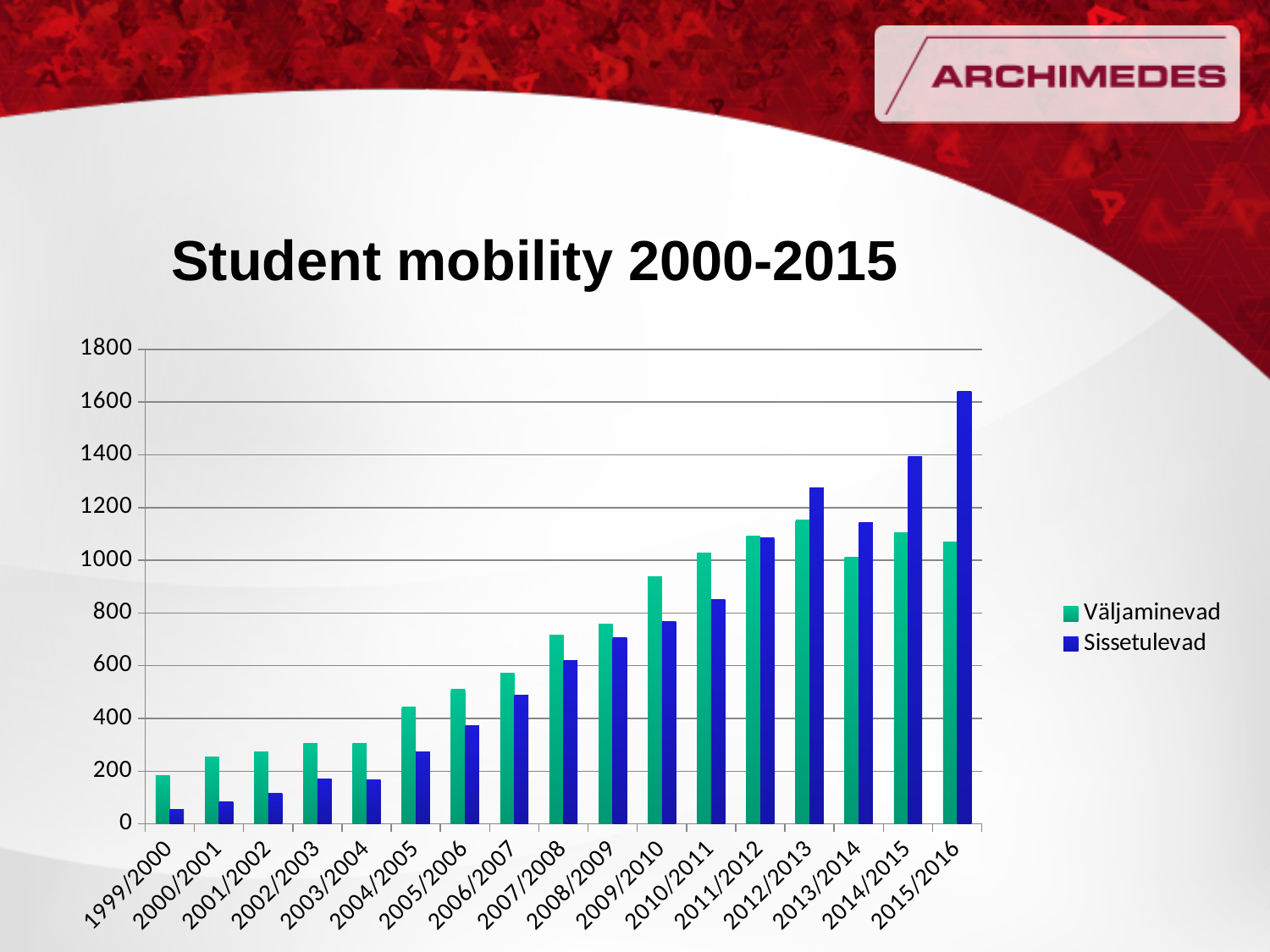
What is the title of the chart? Student mobility 2000-2015 How many academic years are shown on the x axis? 17 In which academic year is the Sissetulevad value highest? 2015/2016 In which academic year is the Väljaminevad value lowest? 1999/2000 How many series does the legend list? 2 In which academic year is the Sissetulevad value lowest? 1999/2000 Which series is shown in blue? Sissetulevad Is the Sissetulevad value for 2015/2016 greater or less than 1400? greater Is the Väljaminevad value for 2009/2010 greater or less than 800? greater What kind of chart is shown on the slide? bar chart In 2015/2016, which is larger: Väljaminevad or Sissetulevad? Sissetulevad Does the Sissetulevad series generally rise or fall from 1999/2000 to 2015/2016? rise